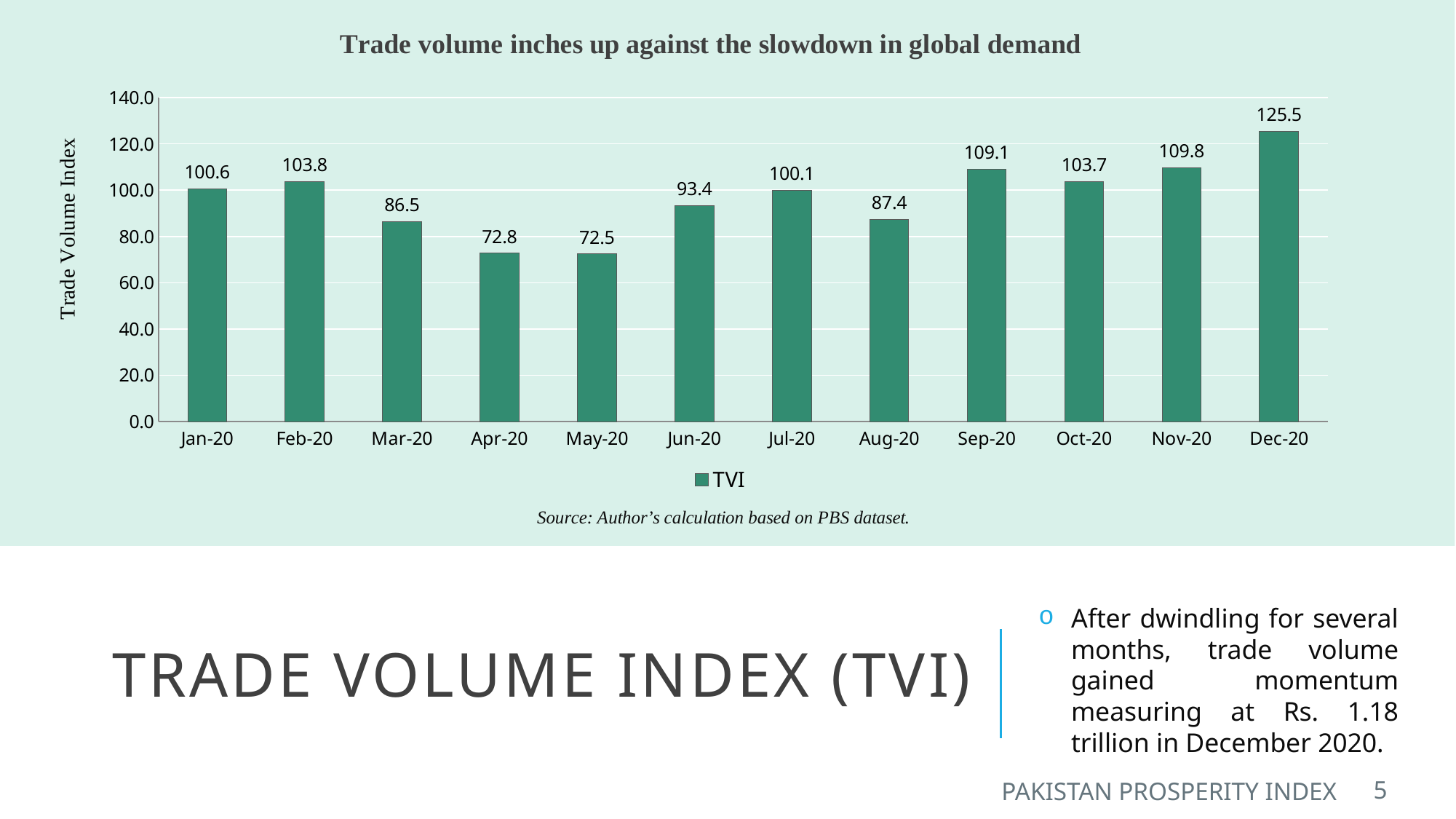
What is the difference between the TVI values for Dec-20 and Nov-20? 15.7 What is the title of the chart? Trade volume inches up against the slowdown in global demand Which is larger, the TVI value for Jun-20 or Aug-20? Jun-20 Which month has the lowest TVI value? May-20 How many months are shown on the x axis? 12 What is the difference between the TVI values for Feb-20 and Mar-20? 17.3 What is the TVI value for Apr-20? 72.8 What is the TVI value for Sep-20? 109.1 What is the TVI value for Dec-20? 125.5 Which month has the highest TVI value? Dec-20 Is the TVI value for Mar-20 greater or less than 80.0? greater What kind of chart is shown on the slide? Bar chart